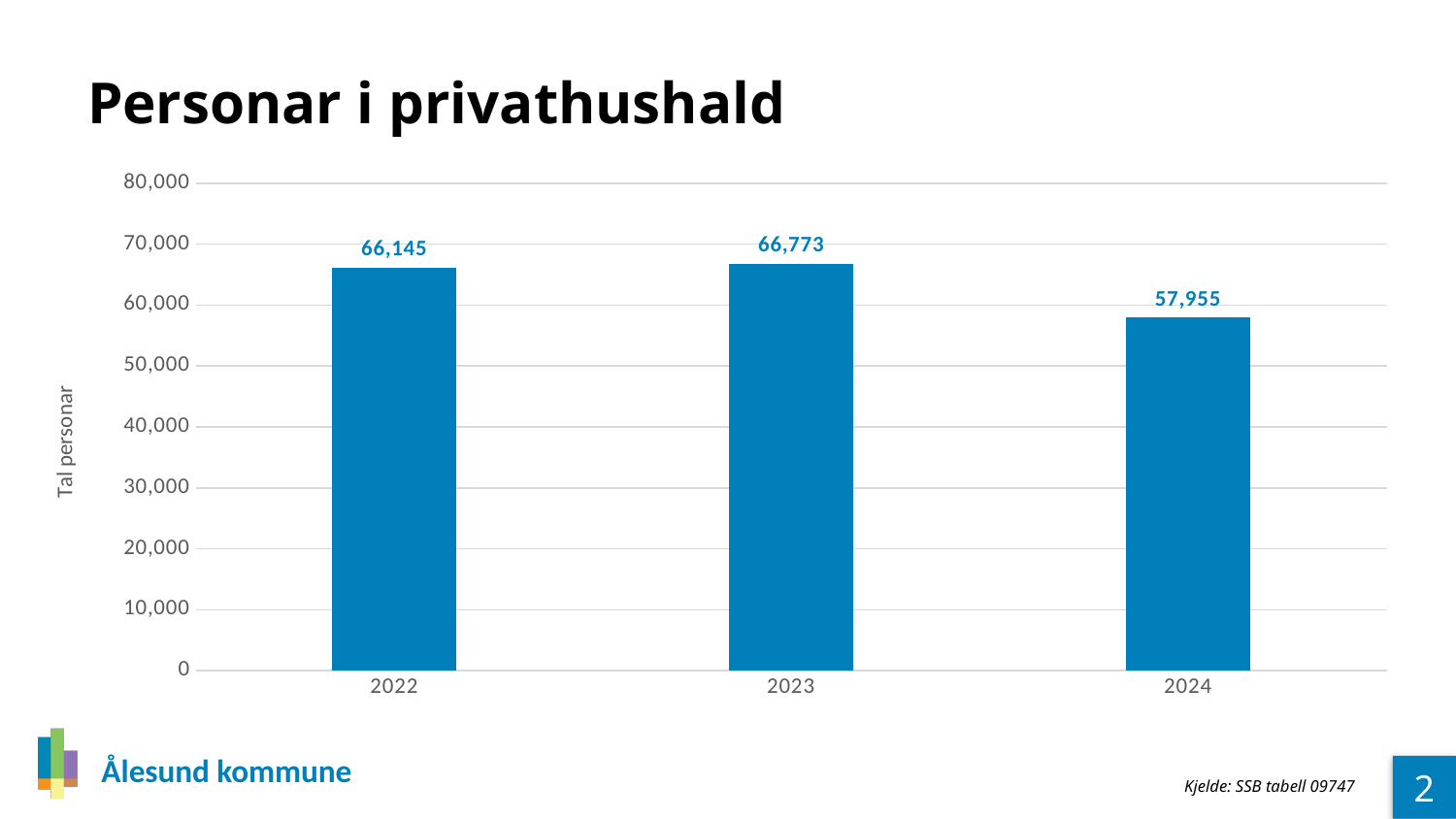
Which year has the highest value? 2023 What kind of chart is shown on the slide? bar chart What is the title of the chart? Personar i privathushald Is the value for 2024 greater or less than 60,000? less What is the difference between the values for 2023 and 2022? 628 Which year has the lowest value? 2024 What is the difference between the values for 2023 and 2024? 8,818 What is the value for 2023? 66,773 Which is larger, the value for 2022 or the value for 2024? 2022 What is the value for 2022? 66,145 What is the value for 2024? 57,955 How many years are shown on the x axis? 3